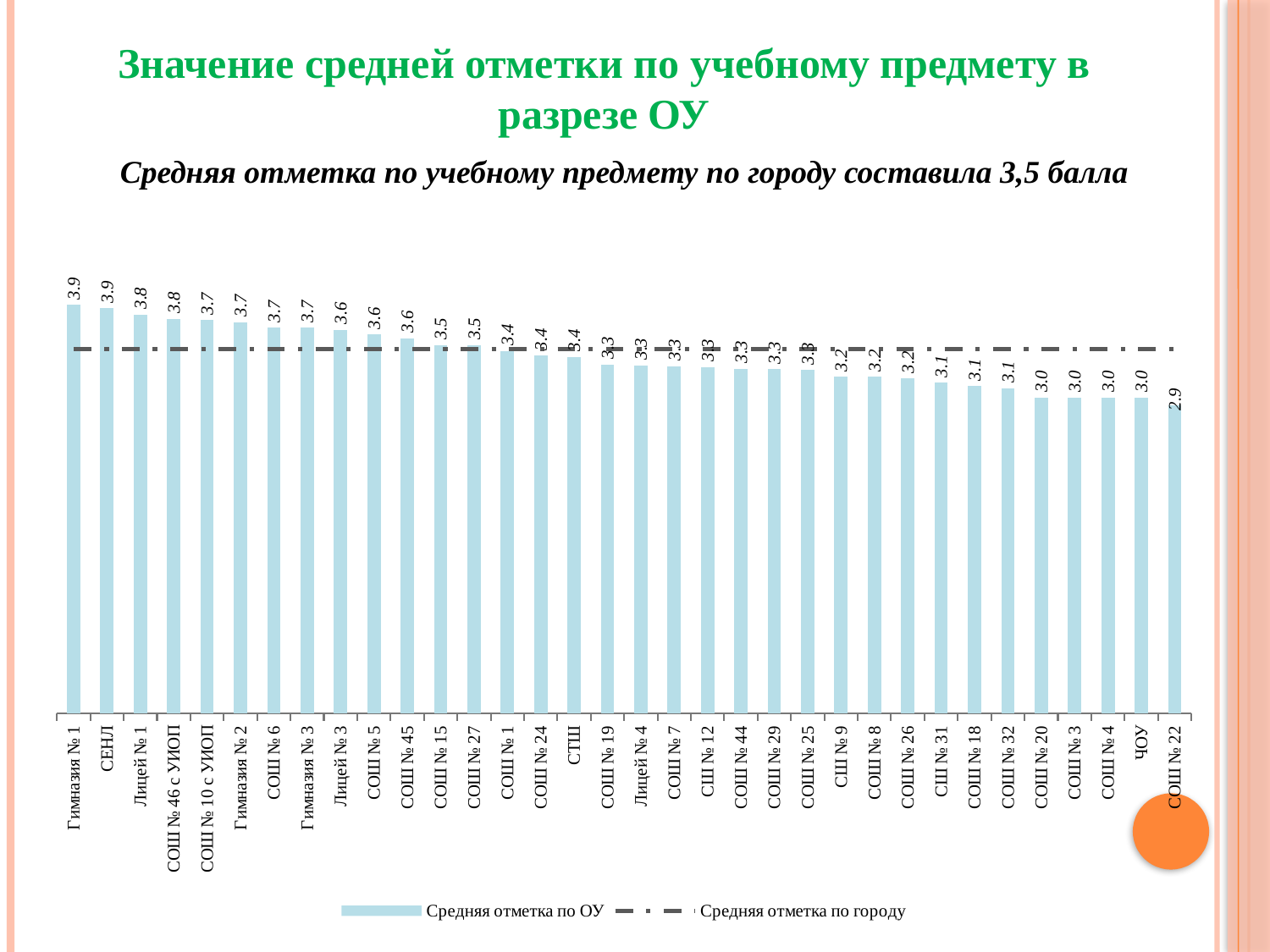
How many series does the legend list? 2 Do the bar values rise or fall from left to right along the x axis? fall What is the city-wide average mark shown by the dashed line, according to the slide? 3,5 балла How many schools (categories) are shown on the x axis? 34 What is the average mark for СОШ № 15? 3.5 What is the average mark (Средняя отметка по ОУ) for Гимназия № 1? 3.9 What type of chart is shown on the slide? bar chart What is the average mark for СОШ № 22? 2.9 Which school has the lowest average mark? СОШ № 22 What is the average mark for СШ № 9? 3.2 Which has a higher average mark, Лицей № 1 or СОШ № 20? Лицей № 1 What is the difference between the average mark of Гимназия № 1 and that of СОШ № 22? 1.0